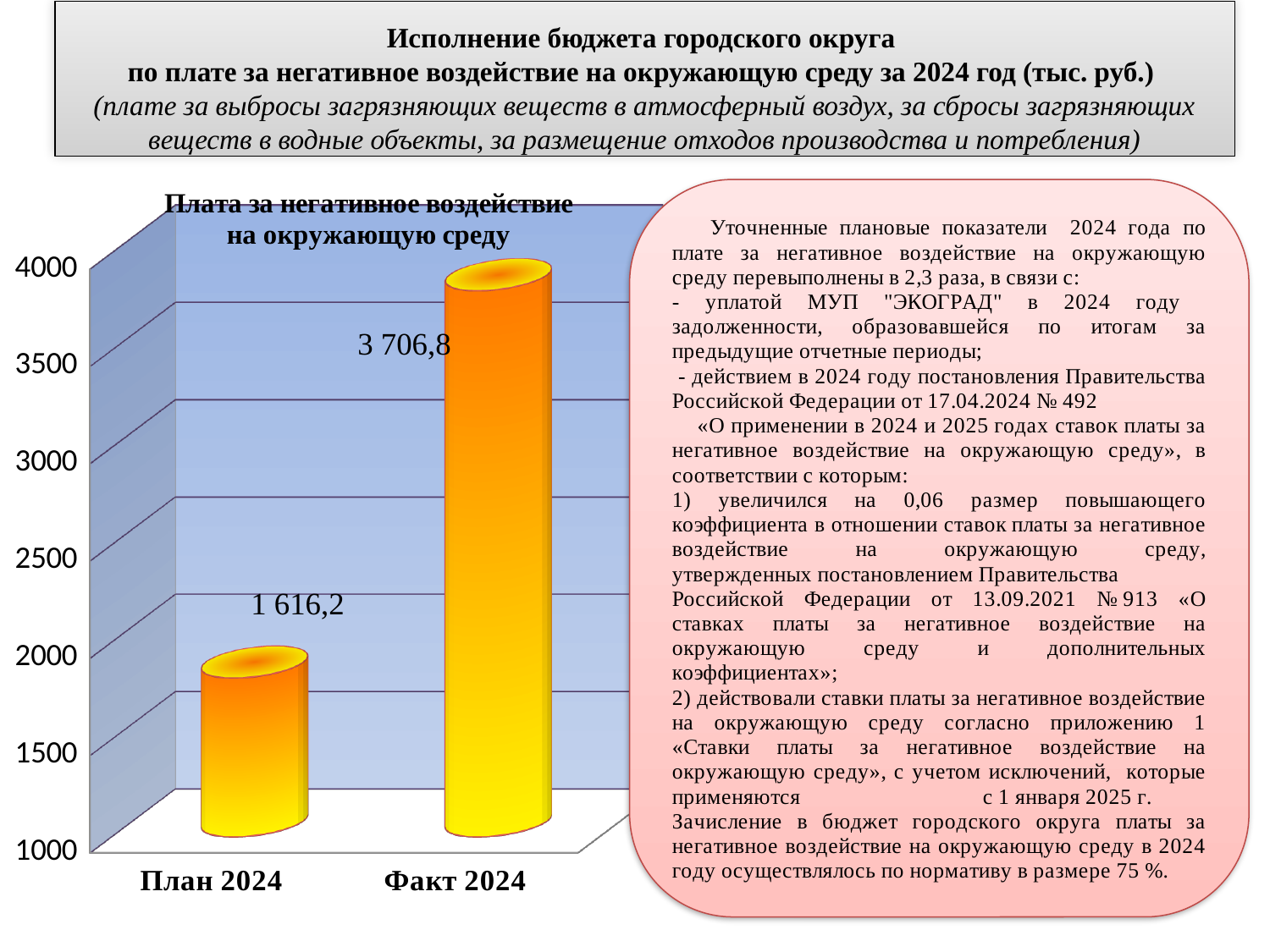
Do the values rise or fall from План 2024 to Факт 2024? rise Which category has the highest value? Факт 2024 Which is larger, the value for План 2024 or the value for Факт 2024? Факт 2024 What is the difference between the values for Факт 2024 and План 2024? 2 090,6 Which category has the lowest value? План 2024 How many categories are shown on the chart? 2 Is the value for План 2024 greater or less than 2000? less What is the title of the chart? Плата за негативное воздействие на окружающую среду Is the value for Факт 2024 greater or less than 3500? greater What kind of chart is shown on the slide? bar chart What is the value for Факт 2024? 3 706,8 What is the value for План 2024? 1 616,2